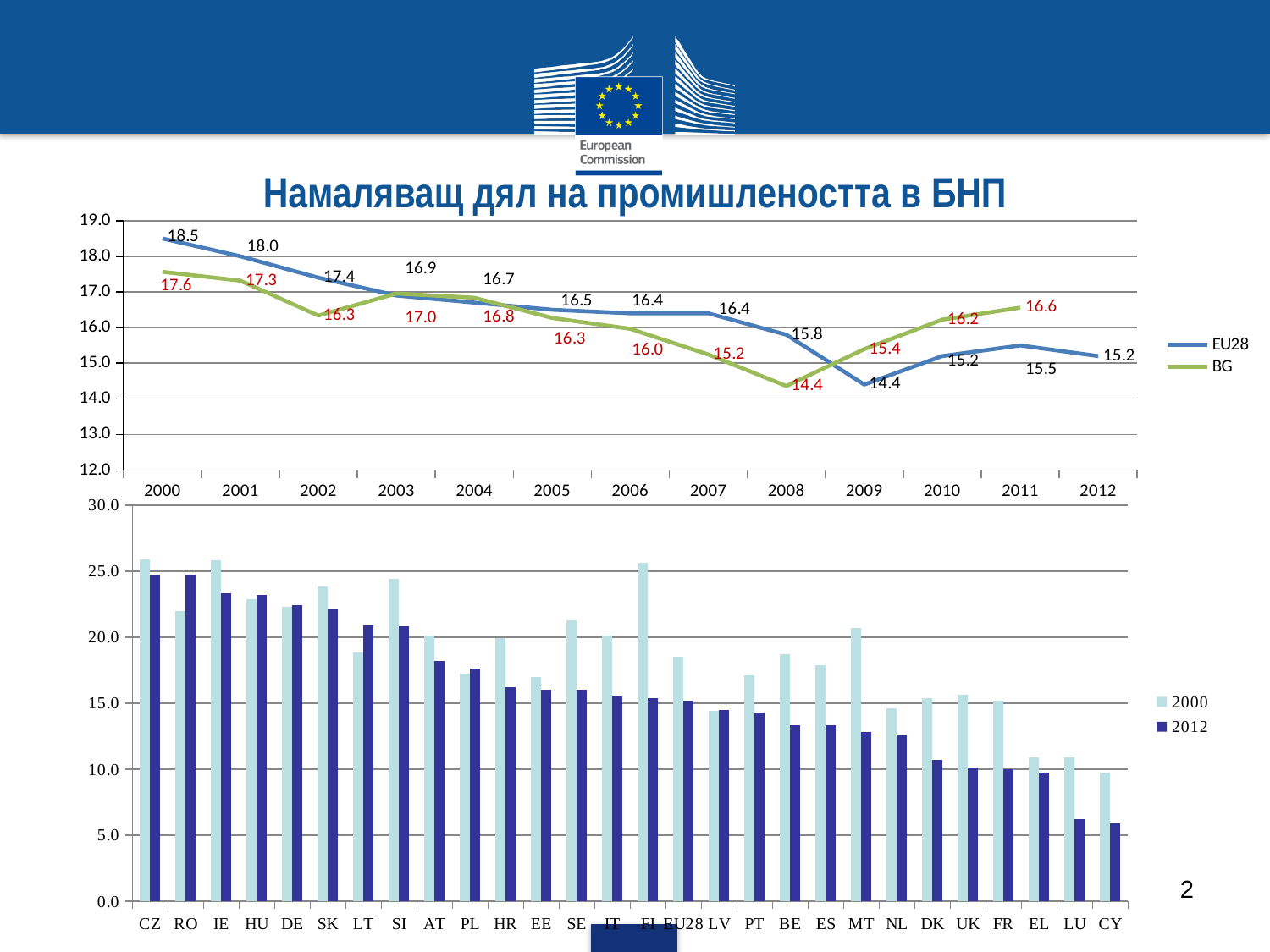
How many series does the legend of the top line chart list? 2 In the top line chart, what is the EU28 value for 2000? 18.5 How many countries/categories are shown on the x axis of the bottom bar chart? 28 In the bottom bar chart, is the 2012 value for CY greater or less than 10.0? less In the top line chart, what is the BG value for 2011? 16.6 In the top line chart, in which year is the EU28 series lowest? 2009 In the top line chart, which is larger in 2010: the EU28 value or the BG value? BG What kind of chart is the bottom chart on the slide? bar chart In the top line chart, what is the BG value for 2008? 14.4 In the top line chart, what is the difference between the EU28 value in 2000 and in 2012? 3.3 In the top line chart, does the EU28 series generally rise or fall from 2000 to 2012? fall In the bottom bar chart, is the 2012 value for CZ greater or less than 20.0? greater